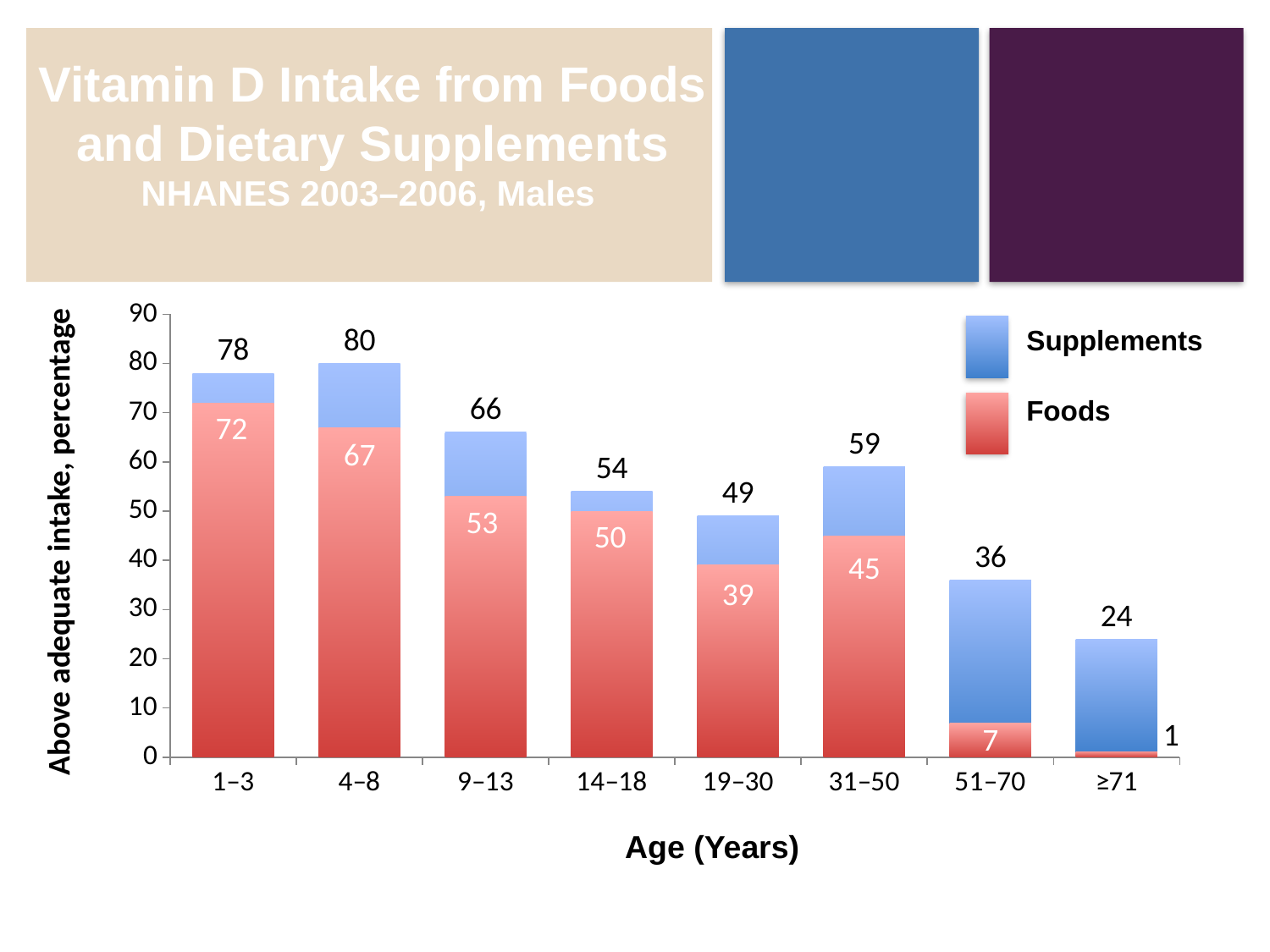
Based on the printed labels, what is the Supplements contribution for the 51–70 age group (total minus Foods)? 29 What is the difference between the total for the 1–3 age group and the total for the ≥71 age group? 54 What is the Foods value for the 19–30 age group? 39 Which age group has the lowest total bar? ≥71 What is the label of the y axis? Above adequate intake, percentage How many series does the legend list? 2 Which is larger, the Foods value for 9–13 or the Foods value for 31–50? 9–13 What is the total value shown above the bar for the 4–8 age group? 80 What is the Foods value for the 51–70 age group? 7 What kind of chart is shown on the slide? Stacked bar chart Which age group has the highest total bar? 4–8 How many age groups are shown on the x axis? 8